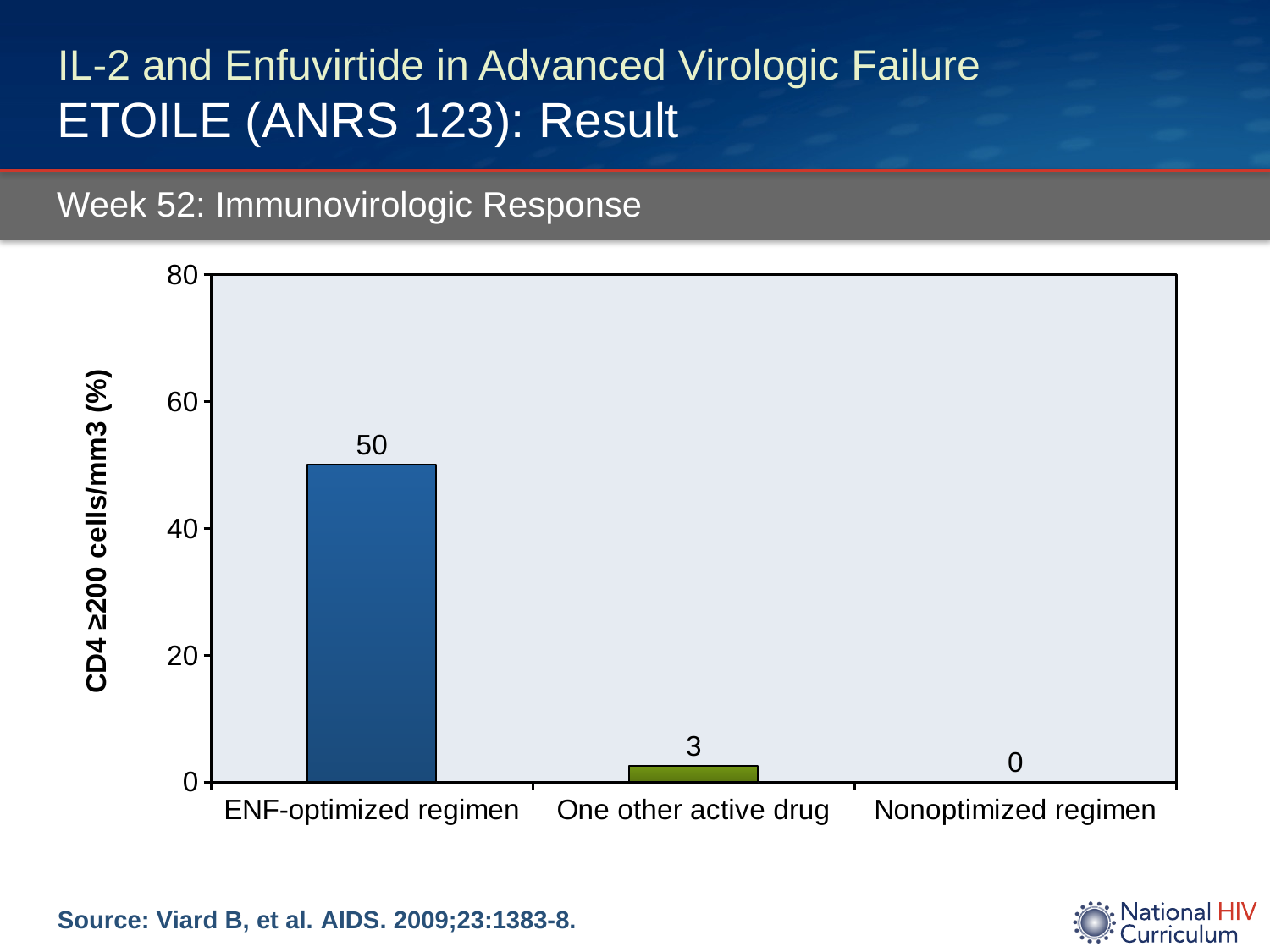
What is the difference between the values for ENF-optimized regimen and One other active drug? 47 Do the values rise or fall from left to right along the x axis? Fall What is the value for One other active drug? 3 Which is larger, the value for One other active drug or the value for Nonoptimized regimen? One other active drug What is the value for ENF-optimized regimen? 50 What is the value for Nonoptimized regimen? 0 How many categories are shown on the x axis? 3 Which category has the lowest value? Nonoptimized regimen Is the value for ENF-optimized regimen greater or less than 40? greater Which category has the highest value? ENF-optimized regimen What is the label of the y axis? CD4 ≥200 cells/mm3 (%) What kind of chart is shown on the slide? Bar chart